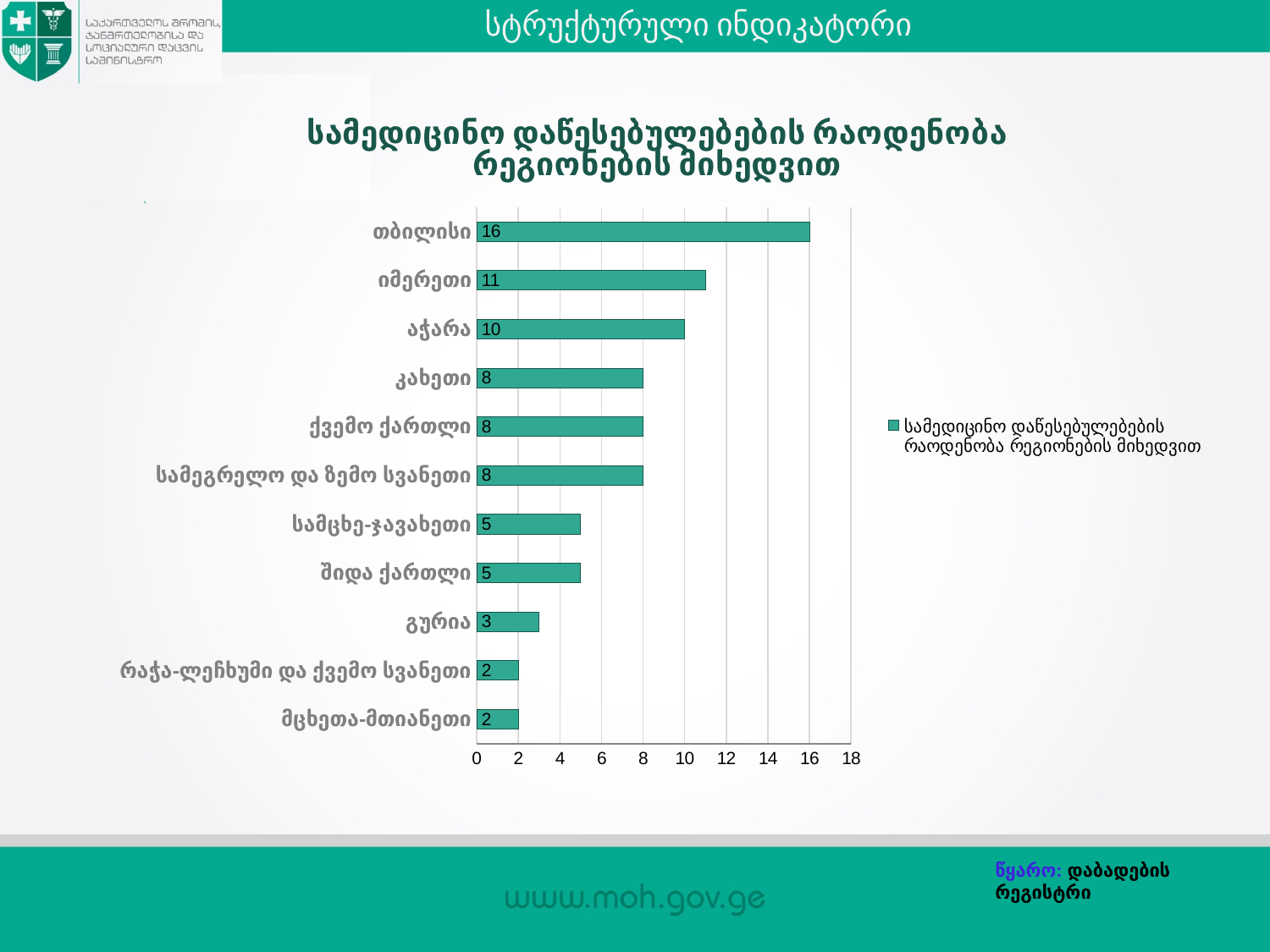
What is the difference between the values for აჭარა and შიდა ქართლი? 5 How many regions are shown on the chart? 11 What is the difference between the values for თბილისი and იმერეთი? 5 Which region has the highest value? თბილისი How many series does the legend list? 1 Is the value for სამცხე-ჯავახეთი greater or less than 8? less What is the value for გურია? 3 What kind of chart is shown on the slide? bar chart What is the value for თბილისი? 16 What is the value for აჭარა? 10 Which is larger, the value for იმერეთი or the value for კახეთი? იმერეთი What is the title of the chart? სამედიცინო დაწესებულებების რაოდენობა რეგიონების მიხედვით